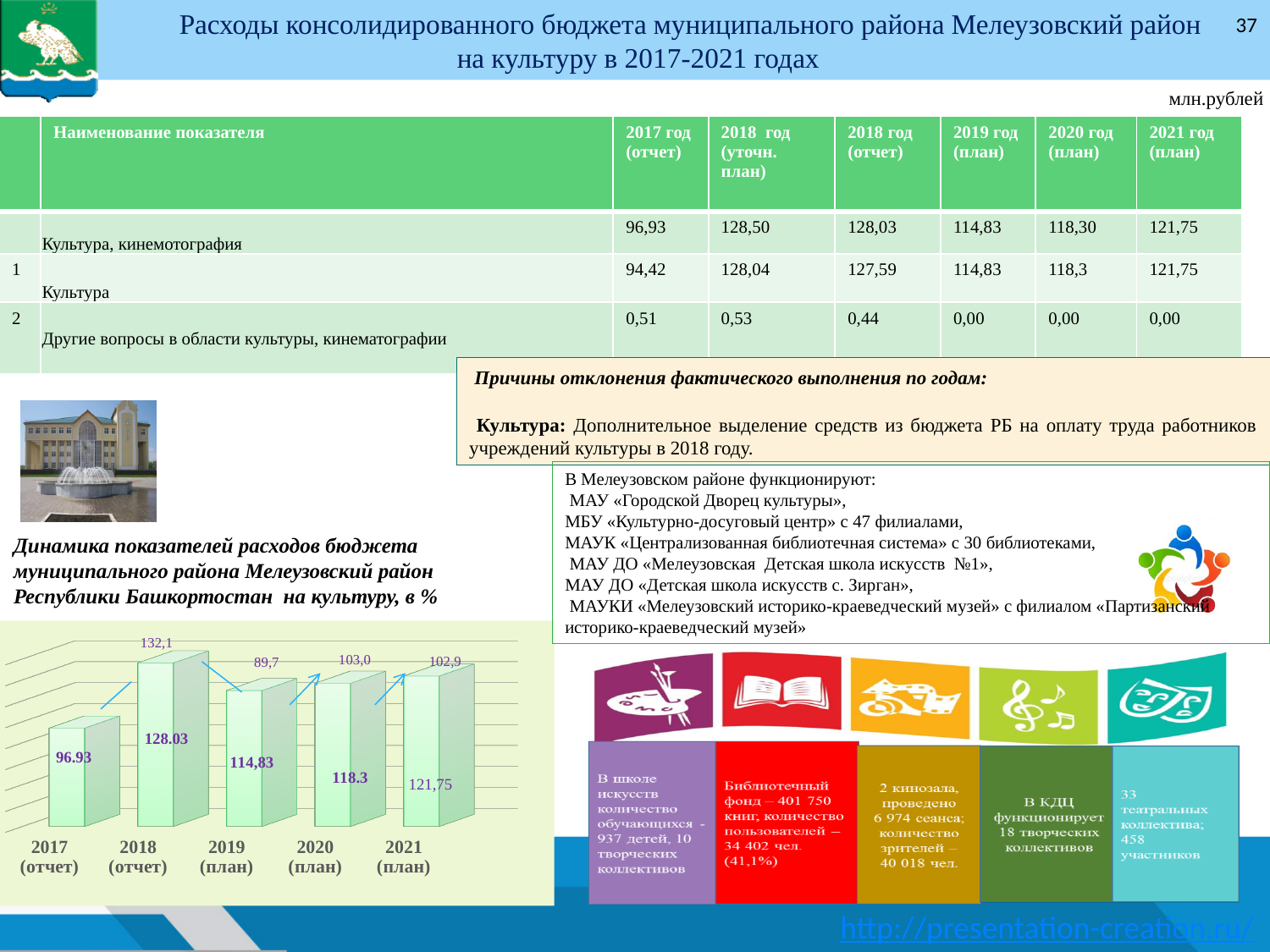
In the bar chart, what is the value for 2021 (план)? 121,75 In the bar chart, what is the difference between the values for 2018 (отчет) and 2017 (отчет)? 31.10 In the bar chart, which year has the highest value? 2018 (отчет) In the bar chart, what is the value for 2017 (отчет)? 96.93 In the bar chart, which is larger: the value for 2020 (план) or the value for 2019 (план)? 2020 (план) In the bar chart, what is the difference between the values for 2021 (план) and 2019 (план)? 6,92 What kind of chart is shown at the bottom left of the slide? bar chart How many years (bars) are shown in the bar chart? 5 In the bar chart, what is the value for 2018 (отчет)? 128.03 In the bar chart, which year has the lowest value? 2017 (отчет) In the bar chart, do the values rise or fall from 2019 (план) to 2021 (план)? rise In the bar chart, what is the value for 2019 (план)? 114,83